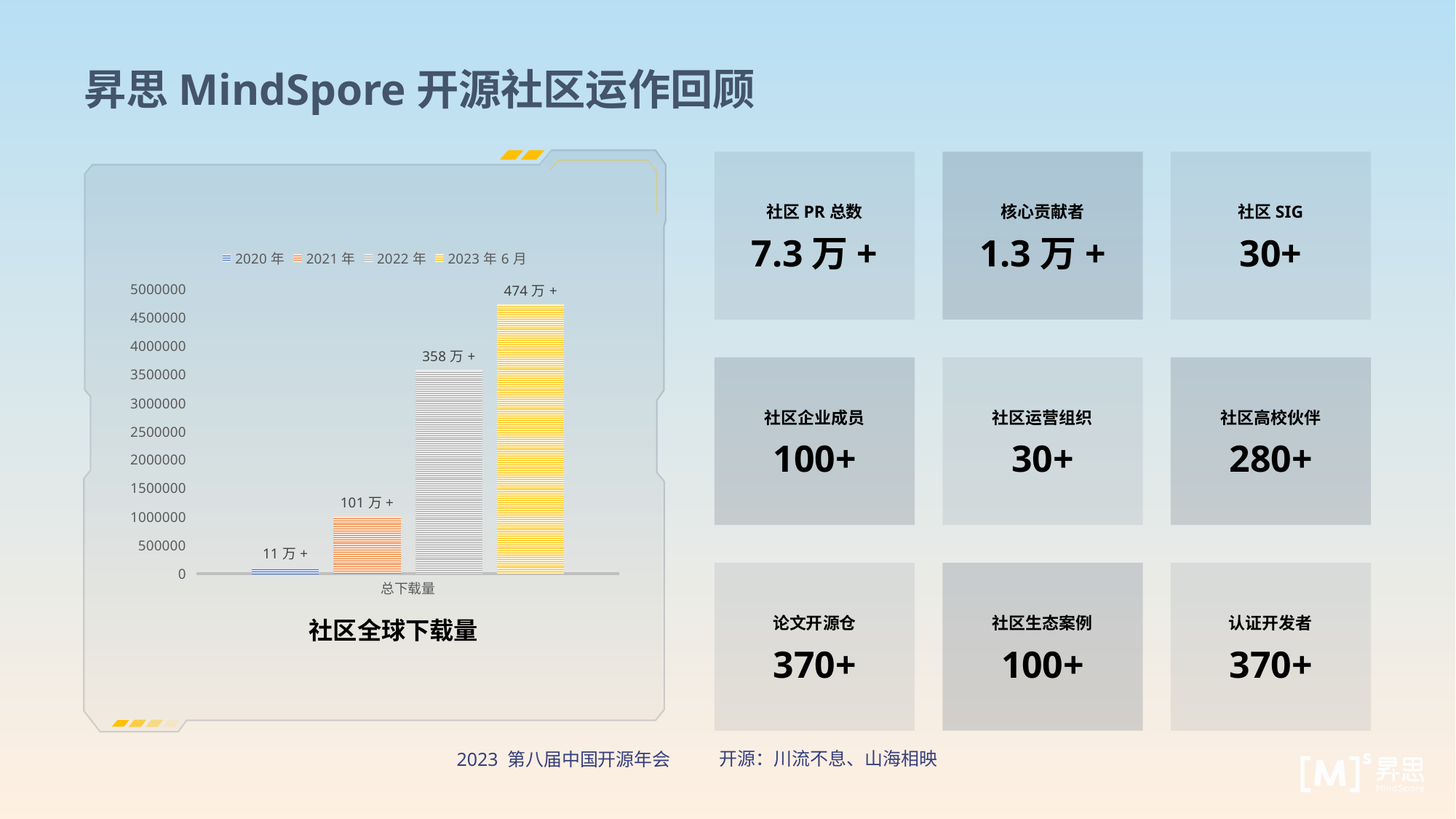
What is the data label for the 2022 年 series in the 社区全球下载量 chart? 358 万 + In the 社区全球下载量 chart, which is larger: the 2021 年 value or the 2022 年 value? 2022 年 What kind of chart is the 社区全球下载量 chart? bar chart Which series has the highest value in the 社区全球下载量 chart? 2023 年 6 月 What is the data label for the 2023 年 6 月 series in the 社区全球下载量 chart? 474 万 + What is the data label for the 2021 年 series in the 社区全球下载量 chart? 101 万 + In the 社区全球下载量 chart, is the value for 2020 年 greater or less than 500000? less Do the values in the 社区全球下载量 chart rise or fall from 2020 年 to 2023 年 6 月? rise What is the data label for the 2020 年 series in the 社区全球下载量 chart? 11 万 + In the 社区全球下载量 chart, is the value for 2022 年 greater or less than 3000000? greater How many series does the legend of the 社区全球下载量 chart list? 4 Which series has the lowest value in the 社区全球下载量 chart? 2020 年